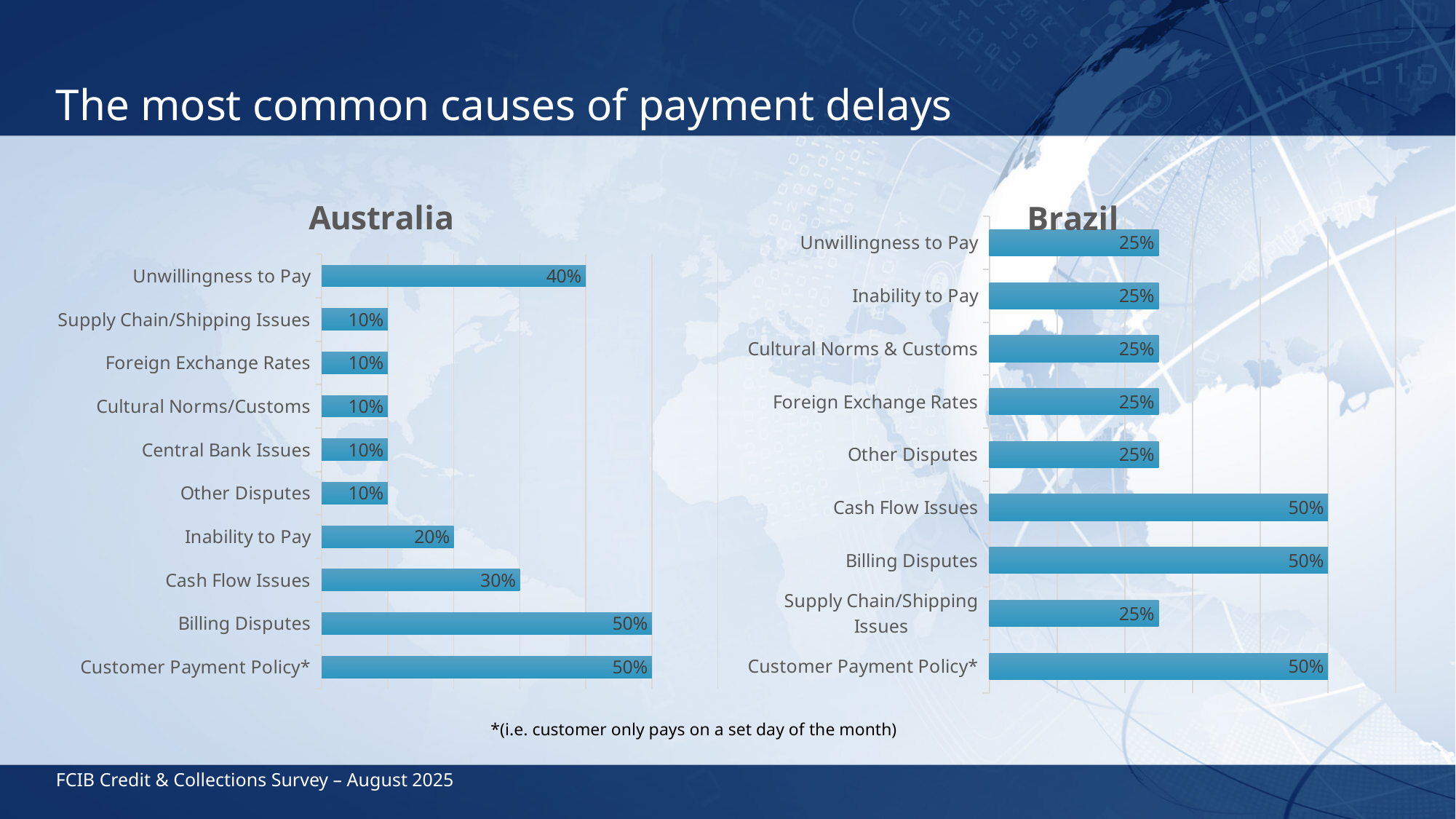
In the Brazil chart, which is larger: Cash Flow Issues or Foreign Exchange Rates? Cash Flow Issues In the Brazil chart, what is the value for Cash Flow Issues? 50% In the Brazil chart, what is the value for Supply Chain/Shipping Issues? 25% In the Australia chart, what is the value for Unwillingness to Pay? 40% How many categories does the Australia chart show? 10 In the Australia chart, what is the value for Inability to Pay? 20% In the Australia chart, which is larger: Cash Flow Issues or Inability to Pay? Cash Flow Issues How many categories does the Brazil chart show? 9 What kind of chart is the Brazil chart? Bar chart In the Australia chart, what is the difference between Unwillingness to Pay and Inability to Pay? 20% In the Brazil chart, what is the difference between Billing Disputes and Other Disputes? 25% In the Australia chart, what is the value for Cash Flow Issues? 30%